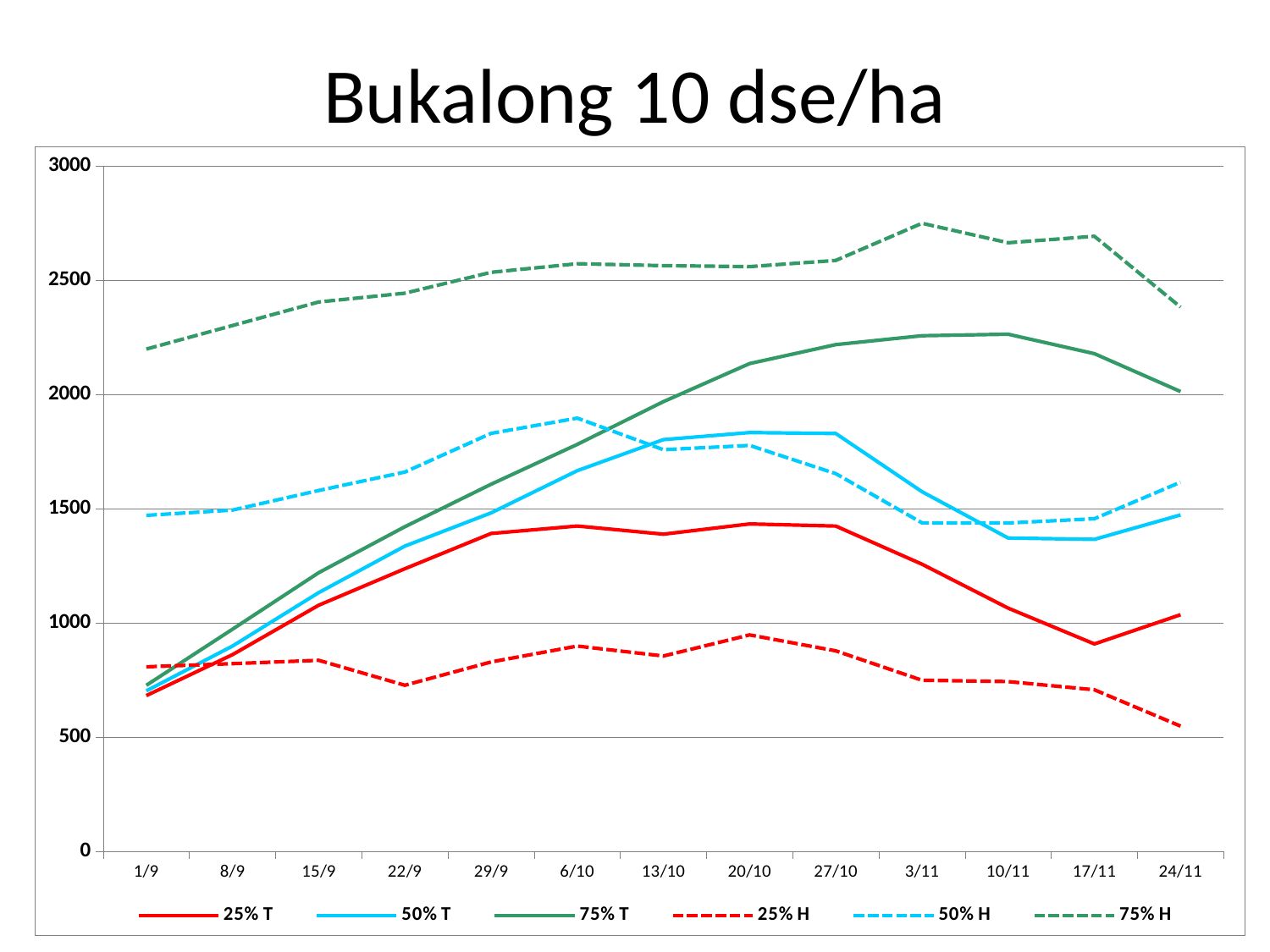
How many dates are shown along the x axis? 13 Which series has the highest value at 1/9? 75% H Is the value for 75% H at 3/11 greater or less than 2500? greater At 6/10, which is larger: 50% H or 50% T? 50% H Is the value for 25% H at 24/11 greater or less than 1000? less Which series has the lowest value at 24/11? 25% H Does the 75% T series rise or fall from 1/9 to 27/10? rise What kind of chart is shown on the slide? line chart How many series does the legend list? 6 Is the value for 50% T at 6/10 greater or less than 1500? greater At 24/11, which is larger: 75% T or 50% T? 75% T What is the title of the chart? Bukalong 10 dse/ha